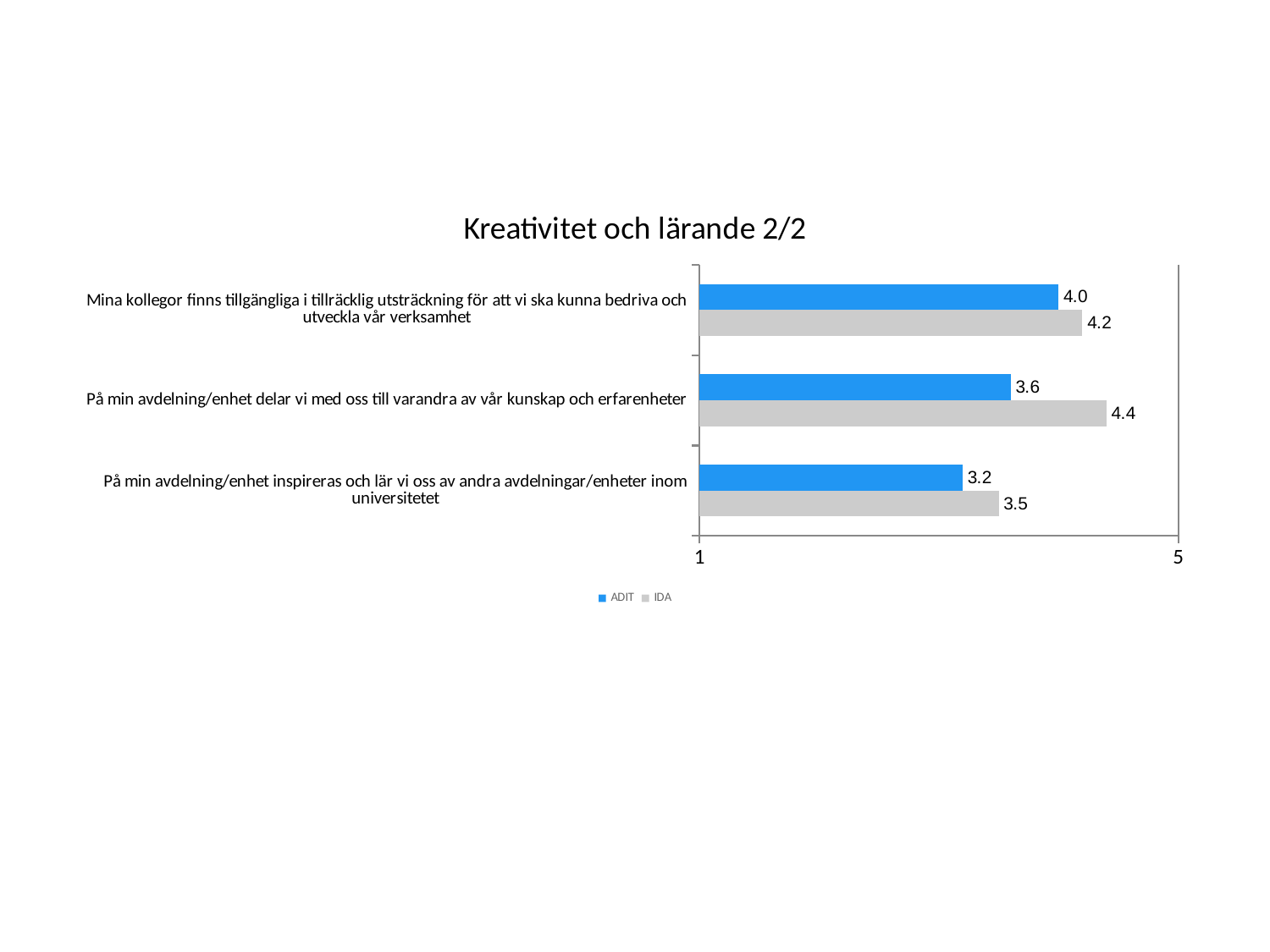
Which category has the lowest ADIT value? På min avdelning/enhet inspireras och lär vi oss av andra avdelningar/enheter inom universitetet What is the ADIT value for "På min avdelning/enhet inspireras och lär vi oss av andra avdelningar/enheter inom universitetet"? 3.2 Which category has the highest IDA value? På min avdelning/enhet delar vi med oss till varandra av vår kunskap och erfarenheter What is the IDA value for "Mina kollegor finns tillgängliga i tillräcklig utsträckning för att vi ska kunna bedriva och utveckla vår verksamhet"? 4.2 What is the difference between the IDA and ADIT values for "På min avdelning/enhet delar vi med oss till varandra av vår kunskap och erfarenheter"? 0.8 How many series does the legend list? 2 For "På min avdelning/enhet inspireras och lär vi oss av andra avdelningar/enheter inom universitetet", which series has the larger value, ADIT or IDA? IDA How many categories are shown in the chart? 3 What is the IDA value for "På min avdelning/enhet delar vi med oss till varandra av vår kunskap och erfarenheter"? 4.4 What kind of chart is shown on the slide? Bar chart What is the ADIT value for "Mina kollegor finns tillgängliga i tillräcklig utsträckning för att vi ska kunna bedriva och utveckla vår verksamhet"? 4.0 What is the title of the chart? Kreativitet och lärande 2/2